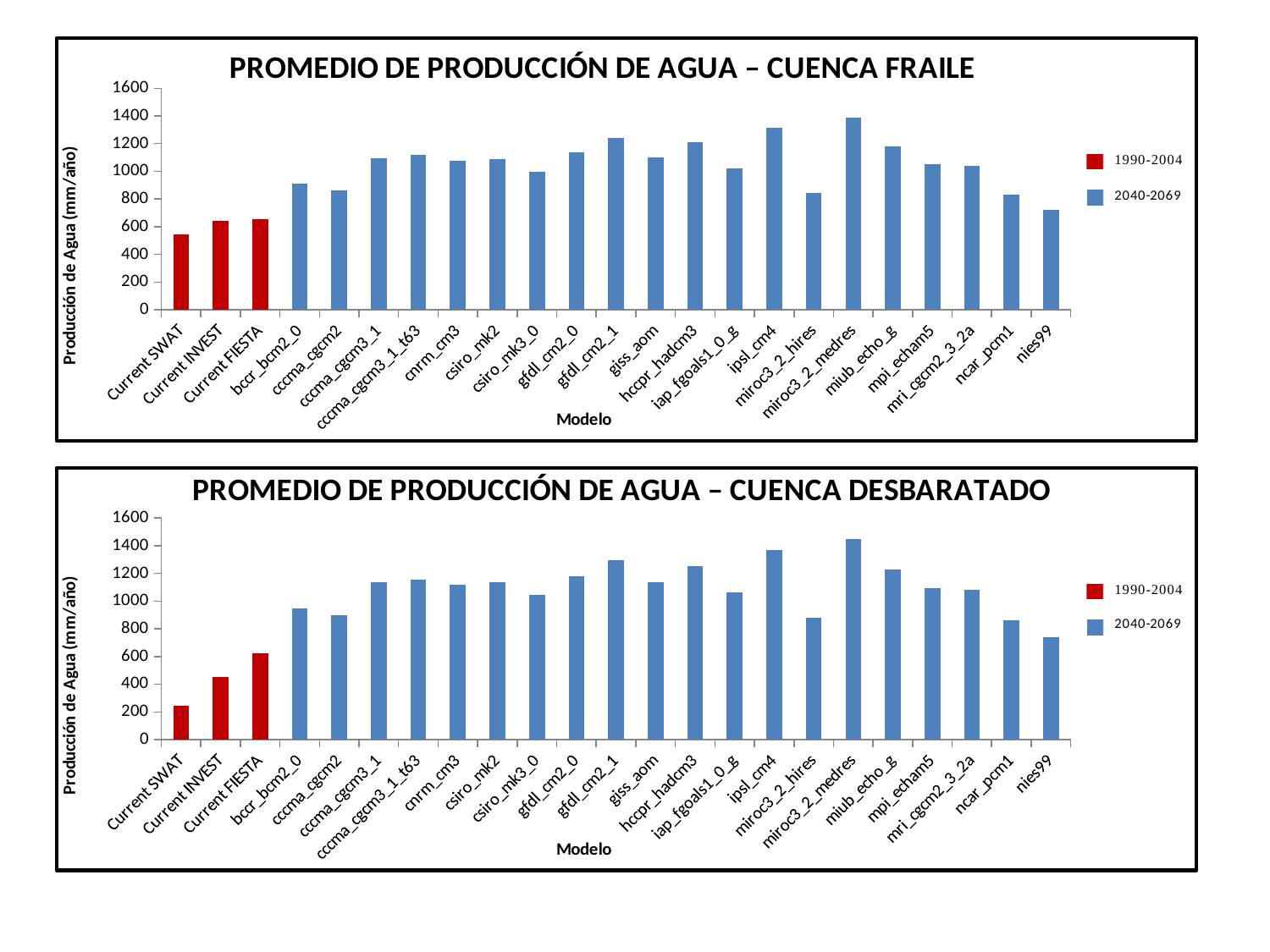
In the 'CUENCA FRAILE' chart, which model has the highest water production? miroc3_2_medres In the 'CUENCA DESBARATADO' chart, which model has the highest water production? miroc3_2_medres In the 'CUENCA DESBARATADO' chart, which is larger: the value for Current INVEST or for Current FIESTA? Current FIESTA What type of chart is the top chart, 'PROMEDIO DE PRODUCCIÓN DE AGUA – CUENCA FRAILE'? Bar chart How many series does the legend of the 'CUENCA DESBARATADO' chart list? 2 In the 'CUENCA DESBARATADO' chart, which category has the lowest water production? Current SWAT How many categories (models) are shown on the x axis of the 'CUENCA FRAILE' chart? 23 In the 'CUENCA FRAILE' chart, which is larger: the value for ipsl_cm4 or for hccpr_hadcm3? ipsl_cm4 In the 'CUENCA DESBARATADO' chart, is the value for ipsl_cm4 greater or less than 1200? greater In the 'CUENCA FRAILE' chart, is the value for nies99 greater or less than 800? less In the 'CUENCA DESBARATADO' chart, is the value for Current SWAT greater or less than 400? less In the 'CUENCA FRAILE' chart, which category has the lowest water production? Current SWAT